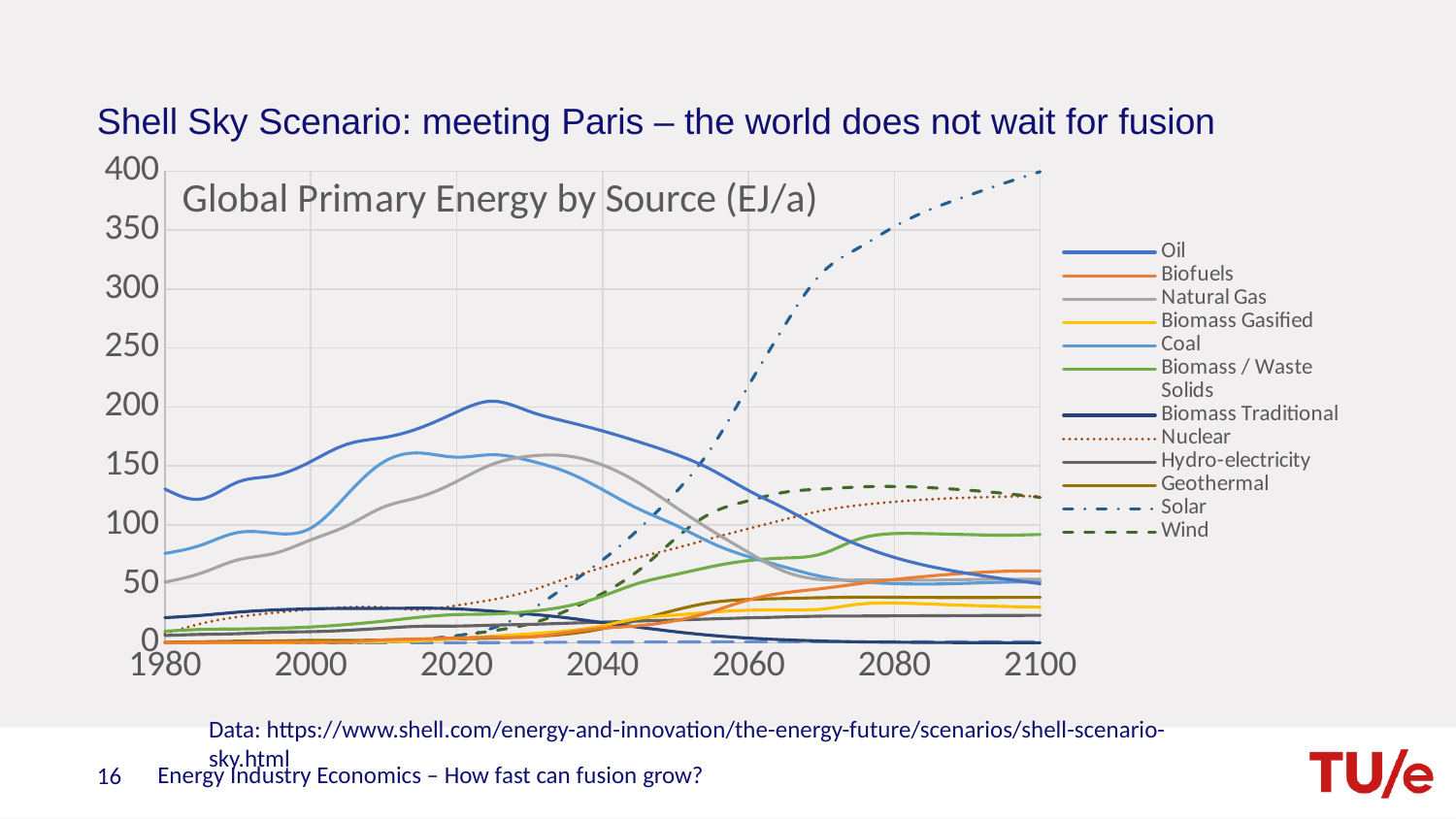
How many series does the legend of the chart list? 12 Does the Oil series rise or fall between 2040 and 2100? fall Which energy source has the highest value in 2100? Solar Is the value for Oil in 2020 greater or less than 150? greater Is the value for Wind in 2100 greater or less than 100? greater What kind of chart is shown on the slide? line chart In 2100, which is larger: the value for Solar or the value for Oil? Solar What is the title of the chart? Global Primary Energy by Source (EJ/a) Is the value for Solar in 2100 greater or less than 350? greater Does the Solar series rise or fall between 2040 and 2100? rise Which series is drawn with a dash-dot line in the chart? Solar